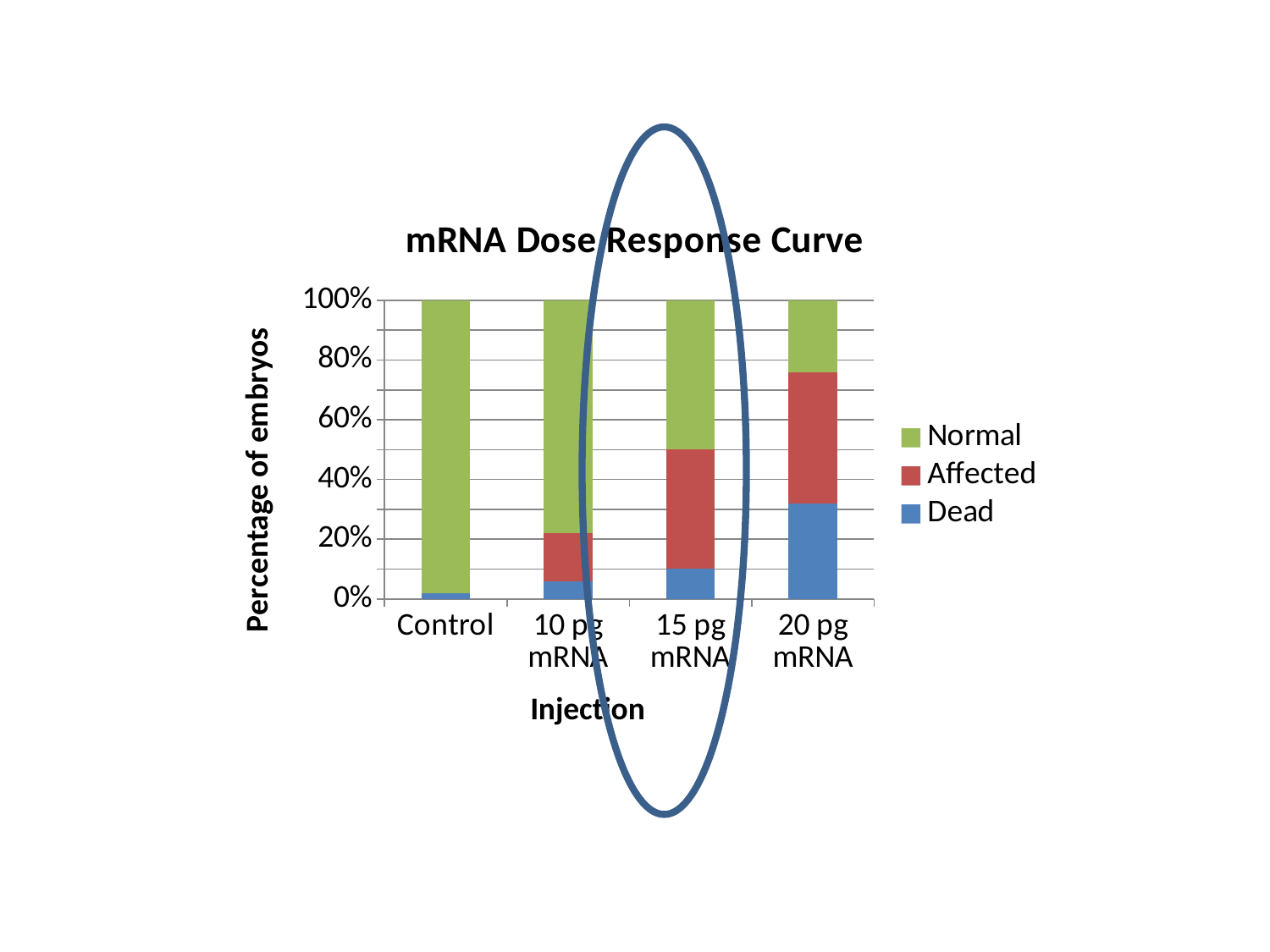
Is the Dead share for 20 pg mRNA greater or less than 20%? greater How many injection categories are shown on the x axis? 4 Which injection category has the smallest Dead share? Control What is the title of the chart? mRNA Dose Response Curve Which injection category has the largest Dead share? 20 pg mRNA Which has a larger Normal share, 10 pg mRNA or 20 pg mRNA? 10 pg mRNA Is the Dead share for 15 pg mRNA greater or less than 20%? less Which injection category has the largest Normal share? Control Which series is shown in blue in the legend? Dead What kind of chart is shown on the slide? Stacked bar chart Does the Dead share rise or fall as the injection dose increases from Control to 20 pg mRNA? rise How many series does the legend list? 3